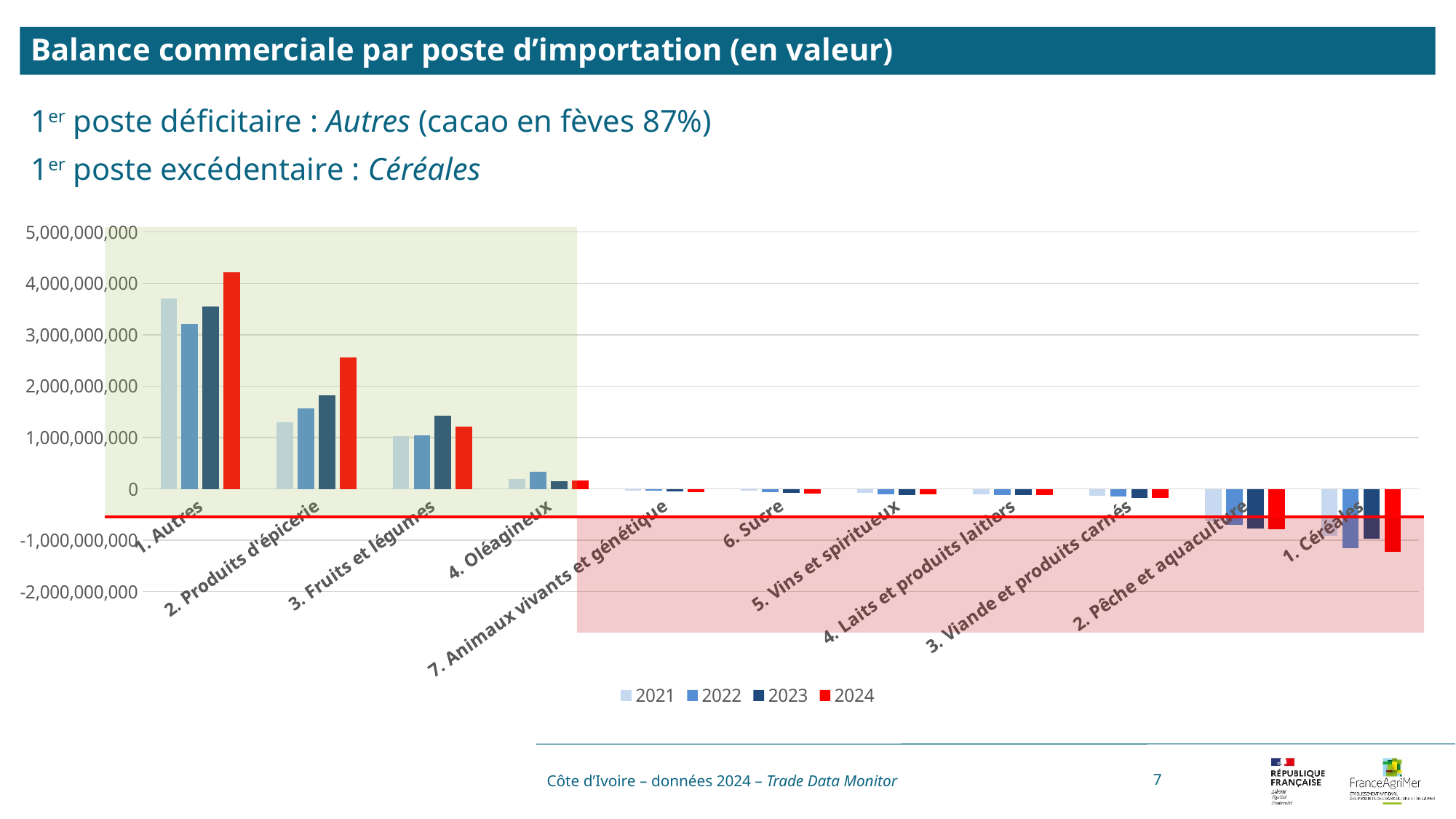
Which category has the lowest 2024 value in the chart? 1. Céréales What colour represents the 2024 series in the chart legend? red Is the 2024 value for 1. Autres greater or less than 3,000,000,000? greater Is the 2024 value for 1. Céréales greater or less than -1,000,000,000? less How many categories are shown on the x axis of the chart? 11 What kind of chart is shown on the slide? bar chart For 1. Autres, which is larger: the 2021 value or the 2024 value? 2024 For 2. Produits d'épicerie, do the values rise or fall from 2021 to 2024? rise Is the 2024 value for 2. Produits d'épicerie greater or less than 2,000,000,000? greater Which has the larger 2024 value: 2. Produits d'épicerie or 3. Fruits et légumes? 2. Produits d'épicerie Which category has the highest 2024 value in the chart? 1. Autres How many series does the chart legend list? 4